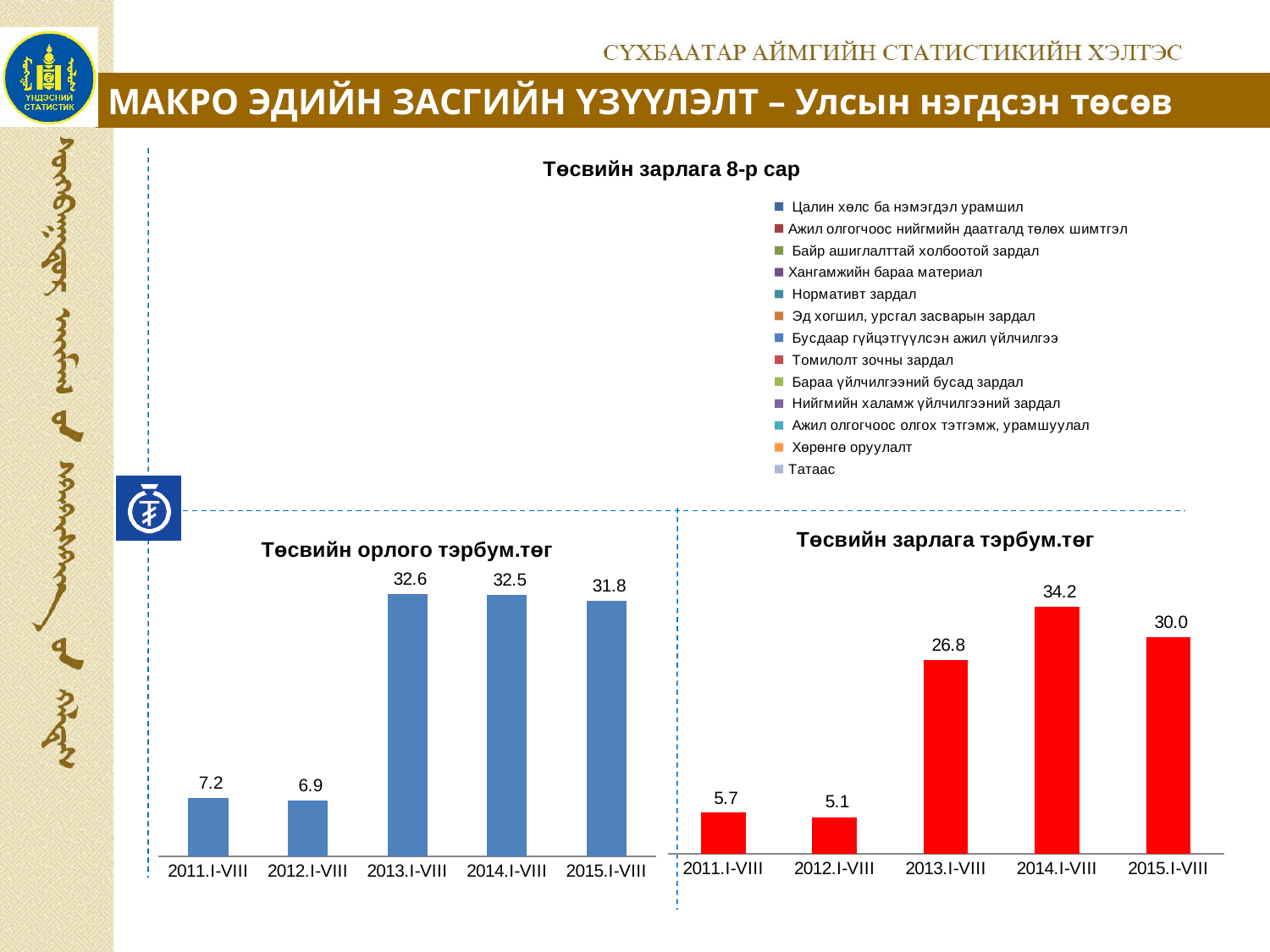
In the 'Төсвийн зарлага тэрбум.төг' chart, which period has the highest value? 2014.I-VIII Which is larger: the 2015.I-VIII value in the 'Төсвийн орлого тэрбум.төг' chart or the 2015.I-VIII value in the 'Төсвийн зарлага тэрбум.төг' chart? Төсвийн орлого тэрбум.төг (31.8) What kind of chart is the 'Төсвийн зарлага тэрбум.төг' chart? Bar chart In the 'Төсвийн зарлага тэрбум.төг' chart, what is the difference between the values for 2014.I-VIII and 2015.I-VIII? 4.2 In the 'Төсвийн орлого тэрбум.төг' chart, what is the value for 2011.I-VIII? 7.2 In the 'Төсвийн орлого тэрбум.төг' chart, what is the difference between the values for 2013.I-VIII and 2012.I-VIII? 25.7 In the 'Төсвийн зарлага тэрбум.төг' chart, what is the value for 2012.I-VIII? 5.1 In the 'Төсвийн зарлага тэрбум.төг' chart, which period has the lowest value? 2012.I-VIII In the 'Төсвийн орлого тэрбум.төг' chart, what is the value for 2013.I-VIII? 32.6 How many entries does the legend of the 'Төсвийн зарлага 8-р сар' chart list? 13 How many periods are shown on the x axis of the 'Төсвийн орлого тэрбум.төг' chart? 5 In the 'Төсвийн зарлага тэрбум.төг' chart, what is the value for 2014.I-VIII? 34.2